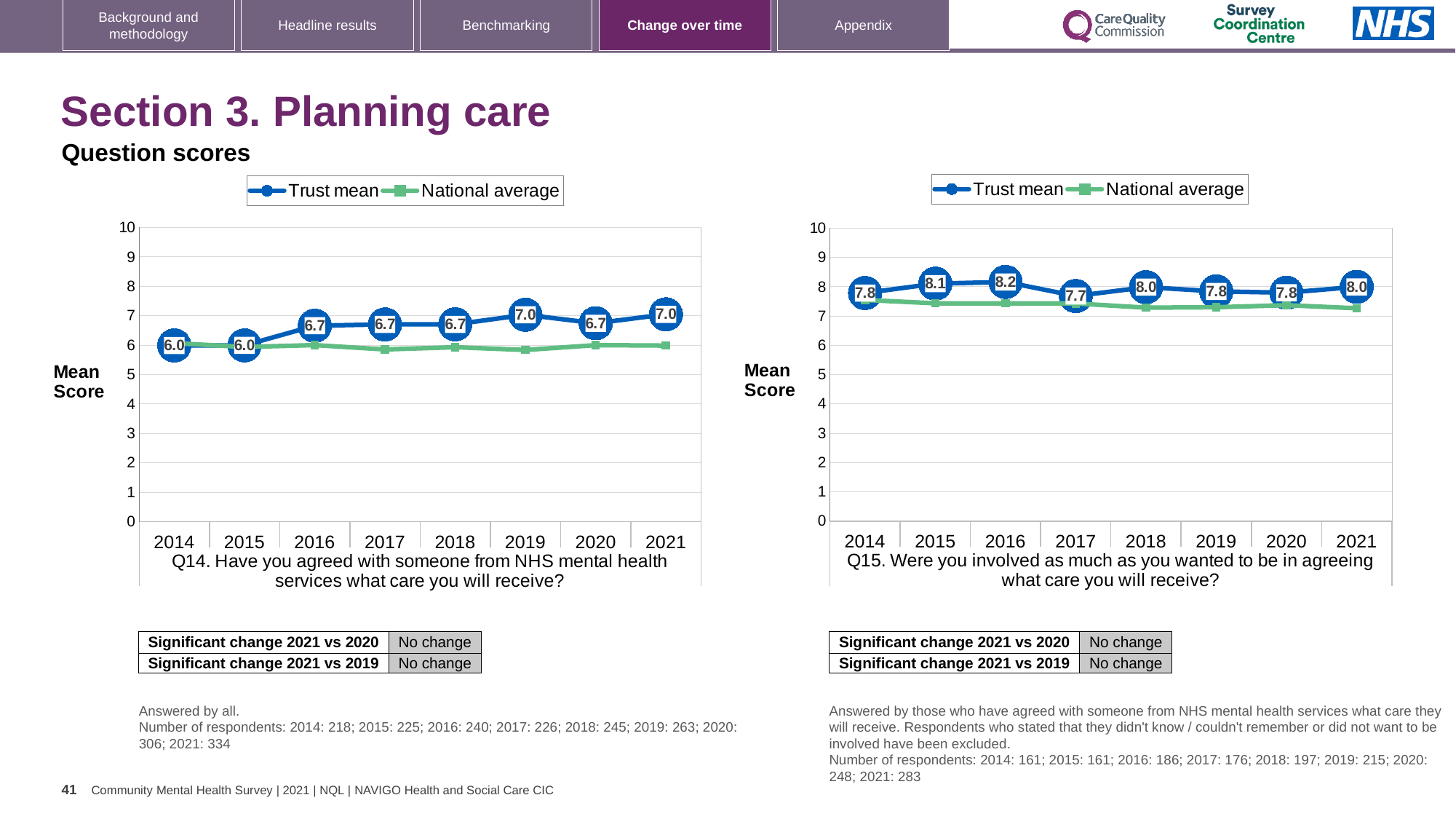
What kind of chart is the Q14 chart on the left? Line chart In the Q15 chart on the right, is the National average value for 2021 greater or less than 8? less How many series does the legend of the Q15 chart on the right list? 2 In the Q15 chart on the right, which year has the highest Trust mean score? 2016 In the Q15 chart on the right, which year has the lowest Trust mean score? 2017 In the Q15 chart on the right, which is larger, the Trust mean for 2015 or the Trust mean for 2019? 2015 In the Q14 chart on the left, what is the difference between the Trust mean scores for 2021 and 2014? 1.0 How many years are plotted on the x axis of the Q14 chart on the left? 8 In the Q14 chart on the left, what is the Trust mean score for 2021? 7.0 In the Q14 chart on the left, what is the Trust mean score for 2014? 6.0 In the Q15 chart on the right, what is the Trust mean score for 2017? 7.7 In the Q14 chart on the left, is the National average value for 2017 greater or less than 6? less